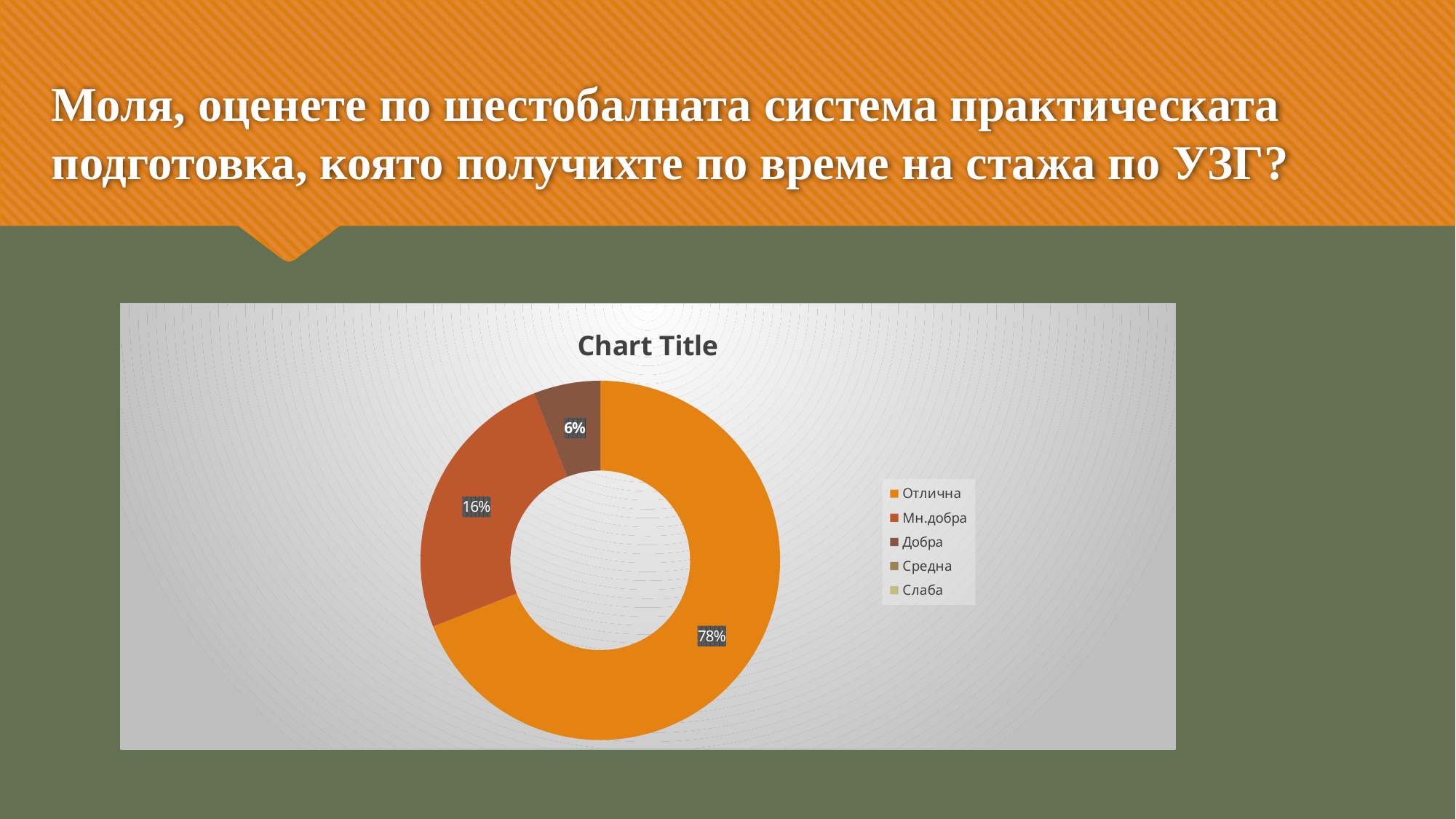
Which of the labelled slices has the smallest share? Добра What share of the doughnut chart does Отлична take? 78% What is the difference in percentage points between the Отлична and Мн.добра shares? 62 How many slices with data labels are visible in the chart? 3 What is the title shown above the chart? Chart Title What colour is the Отлична slice? Orange What share of the doughnut chart does Мн.добра take? 16% How many entries does the legend list? 5 What share of the doughnut chart does Добра take? 6% Which category has the largest share in the chart? Отлична Which is larger, the share for Мн.добра or the share for Добра? Мн.добра What kind of chart is shown on the slide? Doughnut chart